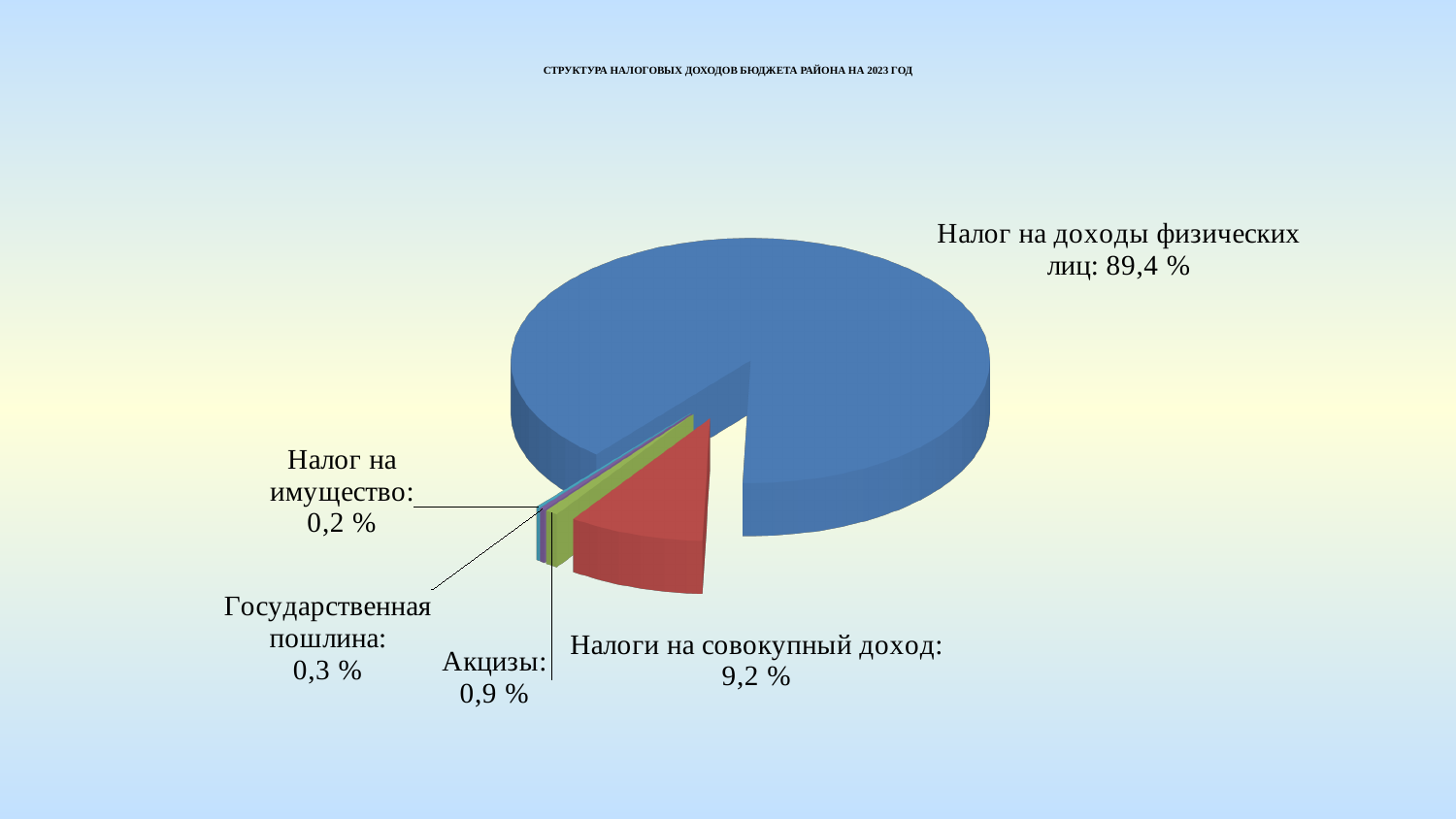
What kind of chart is shown on the slide? Pie chart What is the value shown for "Налог на имущество"? 0,2 % What share of the pie does "Налог на доходы физических лиц" have? 89,4 % What is the difference between the values for "Налог на доходы физических лиц" and "Налоги на совокупный доход"? 80,2 % What is the value shown for "Налоги на совокупный доход"? 9,2 % What is the title of the chart on the slide? СТРУКТУРА НАЛОГОВЫХ ДОХОДОВ БЮДЖЕТА РАЙОНА НА 2023 ГОД What is the value shown for "Государственная пошлина"? 0,3 % Which is larger: the value for "Акцизы" or the value for "Государственная пошлина"? Акцизы How many slices does the pie chart have? 5 Which category has the largest slice of the pie? Налог на доходы физических лиц Which category has the smallest slice of the pie? Налог на имущество What is the value shown for "Акцизы"? 0,9 %